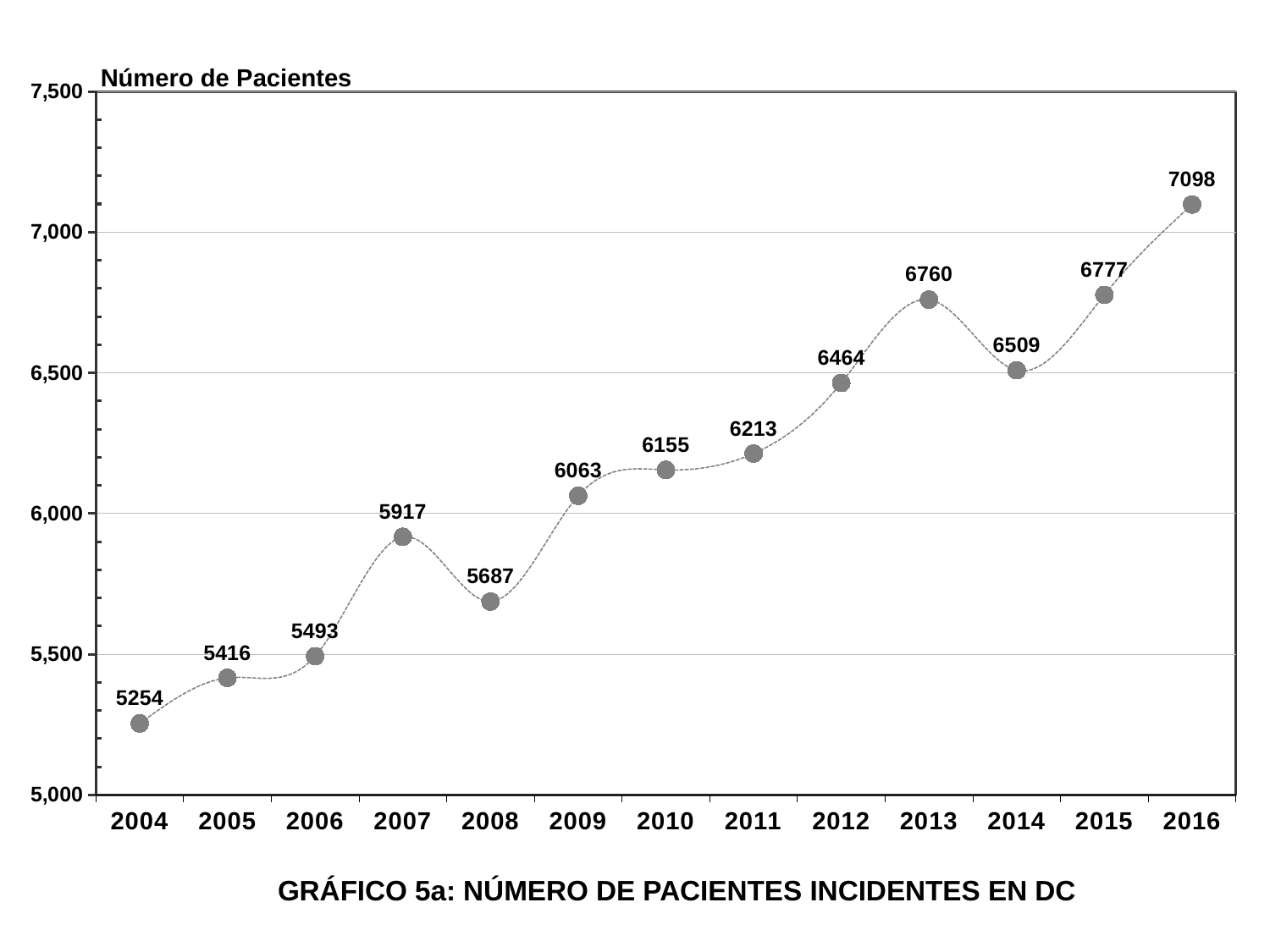
Which year has the highest number of patients? 2016 What is the number of patients in 2016? 7098 Which year has more patients, 2007 or 2008? 2007 How many years are plotted on the chart? 13 Which year has the lowest number of patients? 2004 What is the difference between the number of patients in 2013 and in 2014? 251 What kind of chart is shown on the slide? line chart What is the number of patients in 2004? 5254 What is the title of the chart? GRÁFICO 5a: NÚMERO DE PACIENTES INCIDENTES EN DC What is the difference between the number of patients in 2016 and in 2004? 1844 What is the number of patients in 2013? 6760 Is the value for 2012 greater or less than 6,500? less